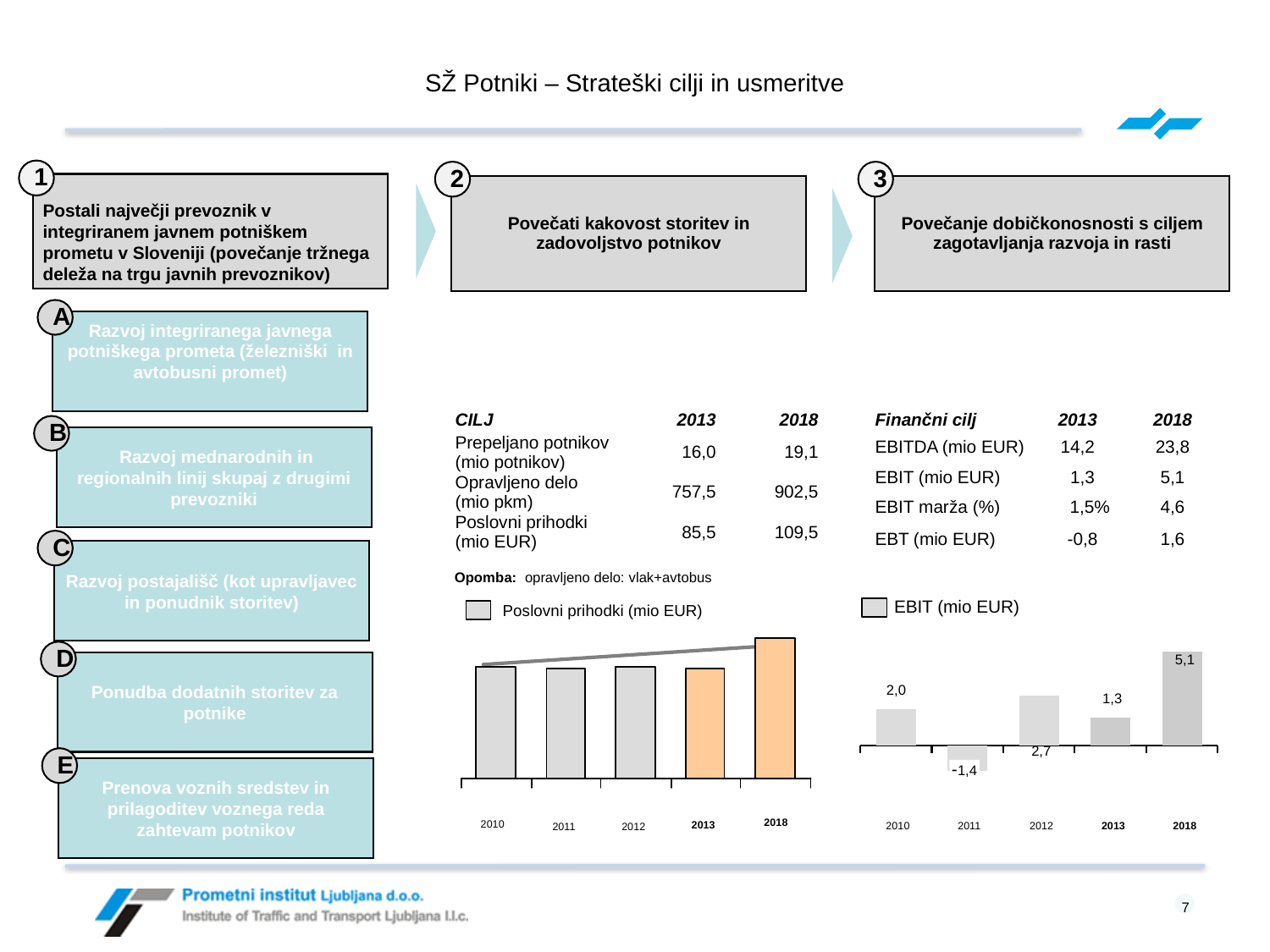
In the EBIT (mio EUR) chart, what is the difference between the 2018 and 2013 values? 3,8 How many years are shown on the x axis of the Poslovni prihodki (mio EUR) chart? 5 In the EBIT (mio EUR) chart, which year has the lowest value? 2011 In the EBIT (mio EUR) chart, what is the value for 2011? -1,4 In the Poslovni prihodki (mio EUR) chart, which year has the tallest bar? 2018 In the Poslovni prihodki (mio EUR) chart, do the values overall rise or fall from 2010 to 2018? rise How many years are shown in the EBIT (mio EUR) chart? 5 In the EBIT (mio EUR) chart, what is the value for 2018? 5,1 In the EBIT (mio EUR) chart, which is larger, the value for 2010 or the value for 2013? 2010 What kind of chart is the EBIT (mio EUR) chart? bar chart In the EBIT (mio EUR) chart, which year has the highest value? 2018 In the EBIT (mio EUR) chart, what is the value for 2013? 1,3